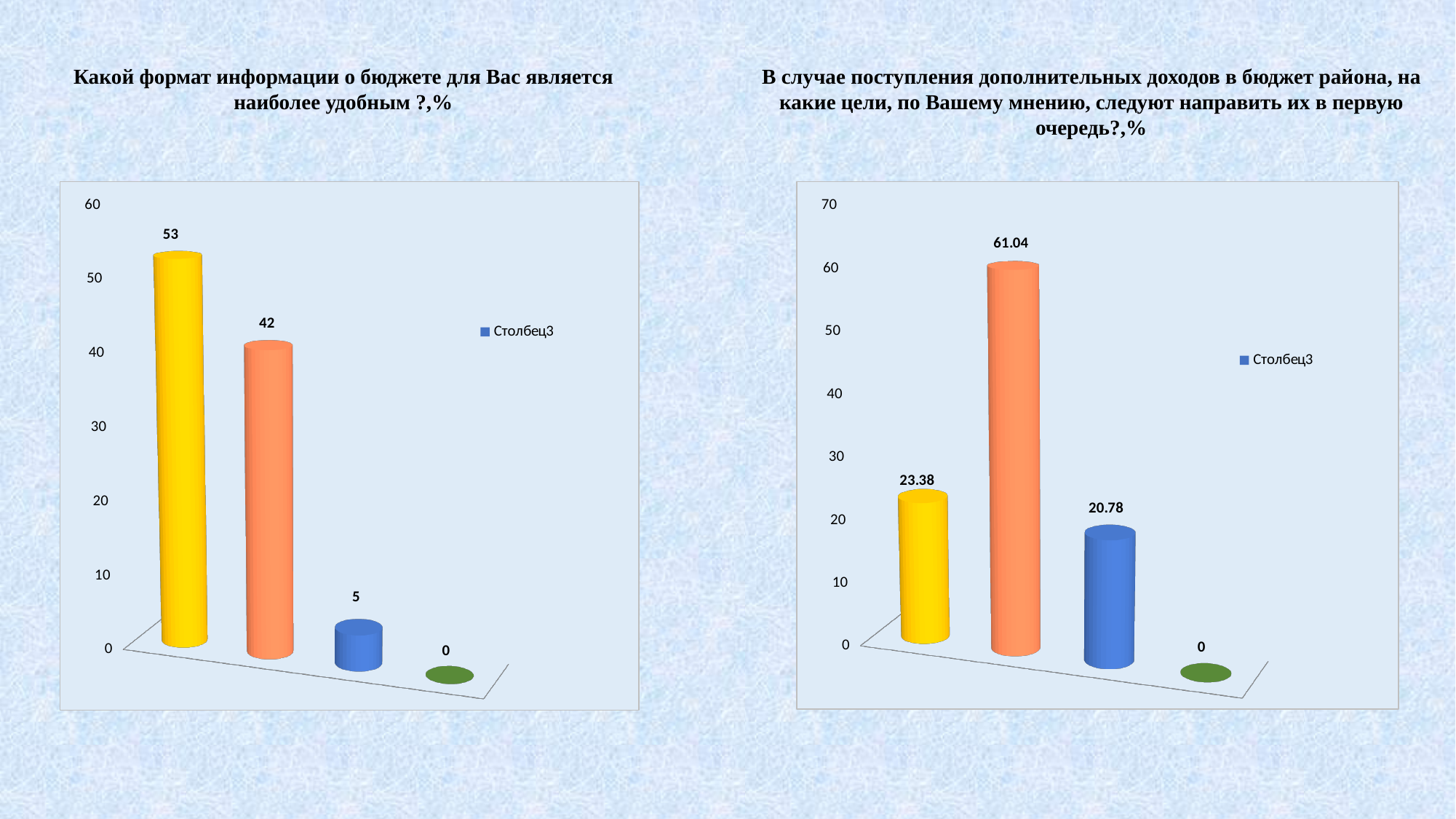
In the right chart, what is the value shown on the blue bar? 20.78 In the right chart, which bar has the highest value? the orange bar (61.04) In the left chart, how many bars are plotted? 4 In the left chart, what is the value shown on the yellow bar? 53 What type of chart is the left chart? bar chart In the left chart, what is the value shown on the blue bar? 5 In the right chart, what is the value shown on the yellow bar? 23.38 In the left chart, what is the difference between the yellow bar and the orange bar? 11 How many series does the legend of the right chart list? 1 In the left chart, what is the value shown on the orange bar? 42 In the right chart, what is the value shown on the orange bar? 61.04 In the right chart, which is larger, the yellow bar or the blue bar? the yellow bar